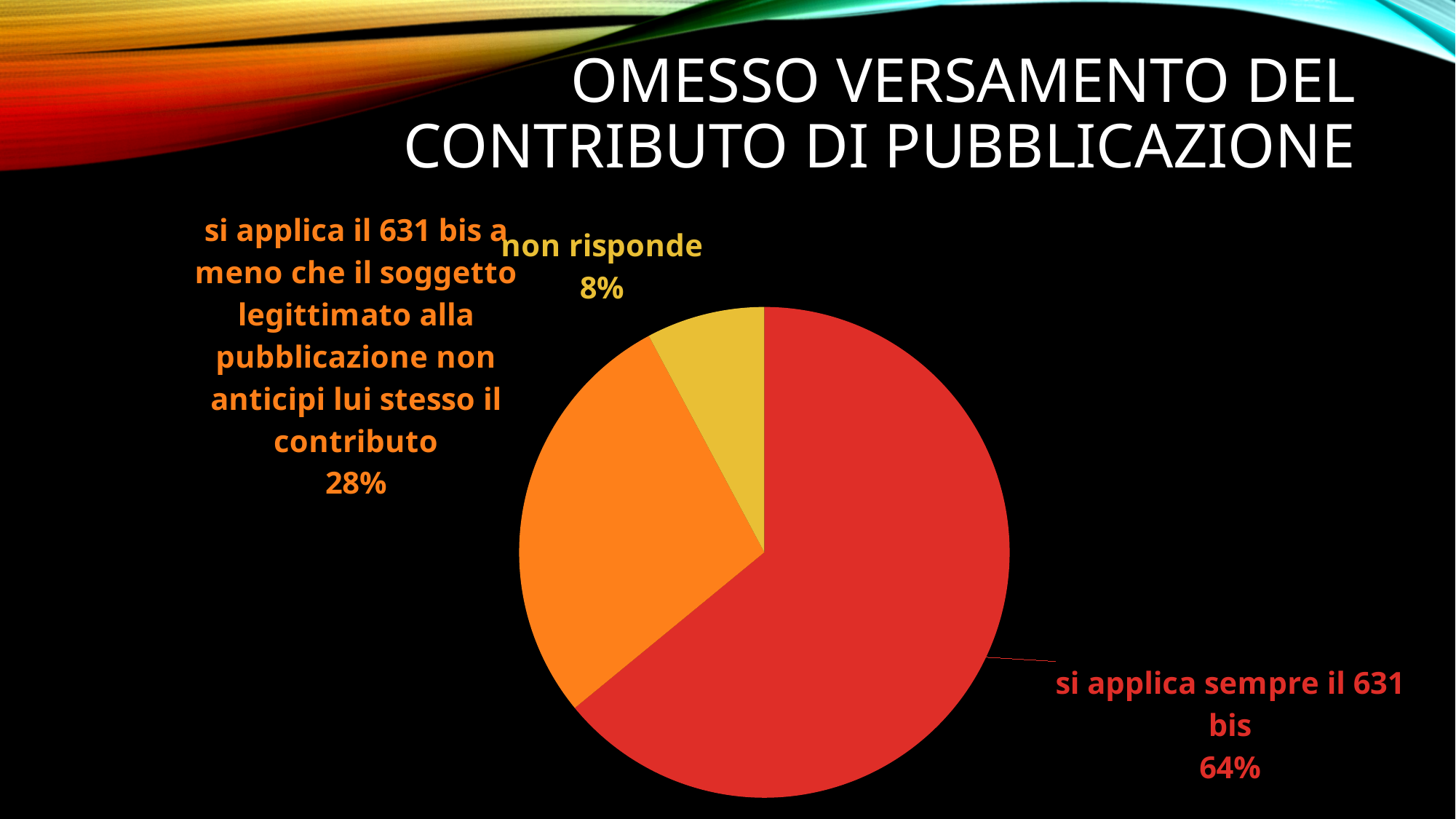
What colour is the slice for "non risponde"? yellow What share of the pie does "non risponde" have? 8% What is the title of the slide containing the pie chart? OMESSO VERSAMENTO DEL CONTRIBUTO DI PUBBLICAZIONE What is the difference in percentage points between "si applica sempre il 631 bis" and "non risponde"? 56 What share of the pie does "si applica il 631 bis a meno che il soggetto legittimato alla pubblicazione non anticipi lui stesso il contributo" have? 28% Which slice of the pie is the smallest? non risponde Which is larger: the share for "non risponde" or the share for "si applica il 631 bis a meno che il soggetto legittimato alla pubblicazione non anticipi lui stesso il contributo"? si applica il 631 bis a meno che il soggetto legittimato alla pubblicazione non anticipi lui stesso il contributo What kind of chart is shown on the slide? pie chart How many slices does the pie chart have? 3 What is the difference in percentage points between "si applica sempre il 631 bis" and the 28% slice? 36 What share of the pie does "si applica sempre il 631 bis" have? 64% Which slice of the pie is the largest? si applica sempre il 631 bis